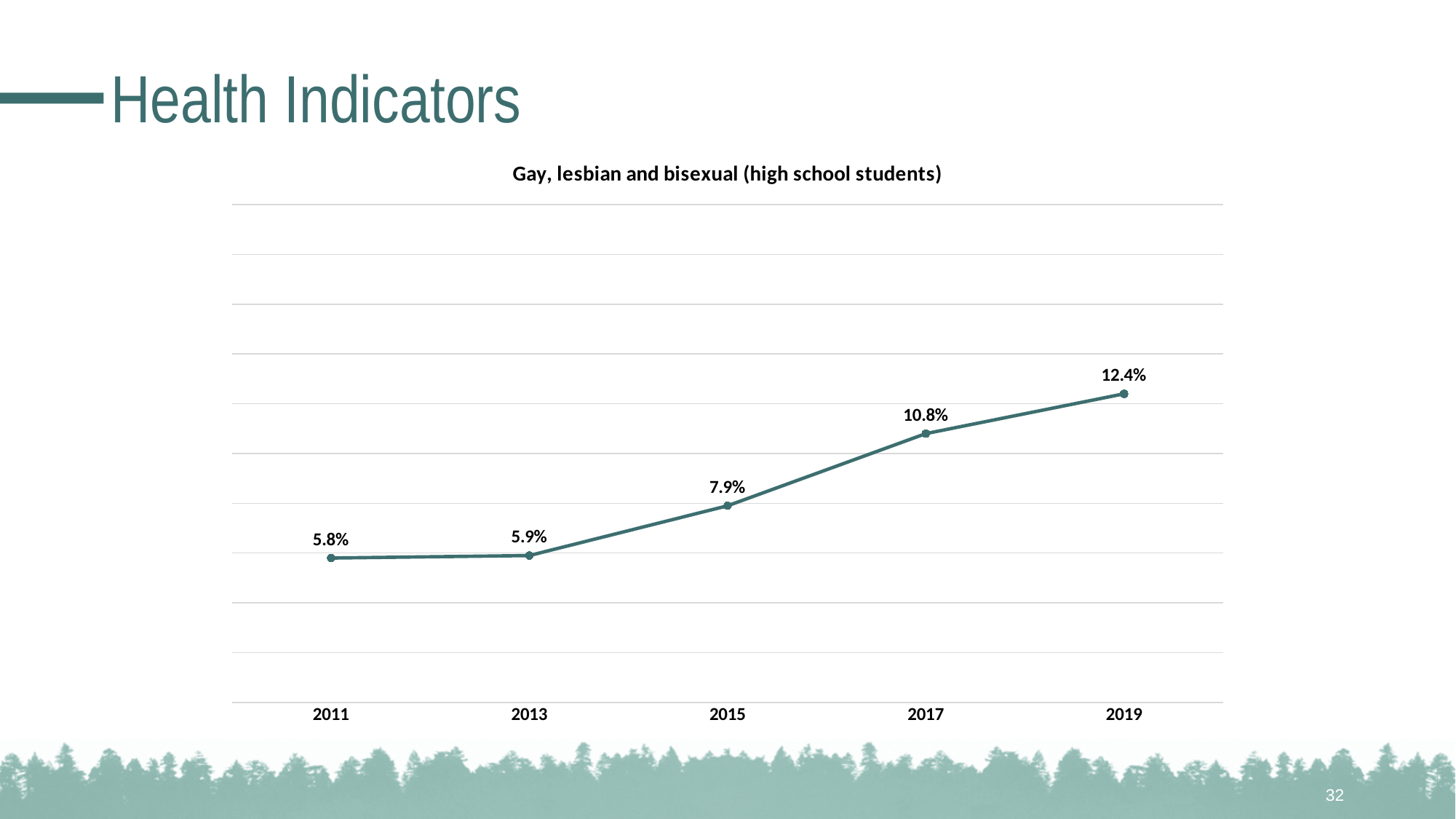
Do the values rise or fall from 2011 to 2019? Rise What kind of chart is shown on the slide? Line chart What is the value for 2011? 5.8% What is the difference between the values for 2019 and 2011? 6.6% Which is larger, the value for 2015 or the value for 2017? 2017 Which year has the highest value? 2019 How many data points are plotted on the chart? 5 What is the value for 2017? 10.8% What is the difference between the values for 2017 and 2015? 2.9% What is the value for 2019? 12.4% What is the value for 2015? 7.9% Which year has the lowest value? 2011